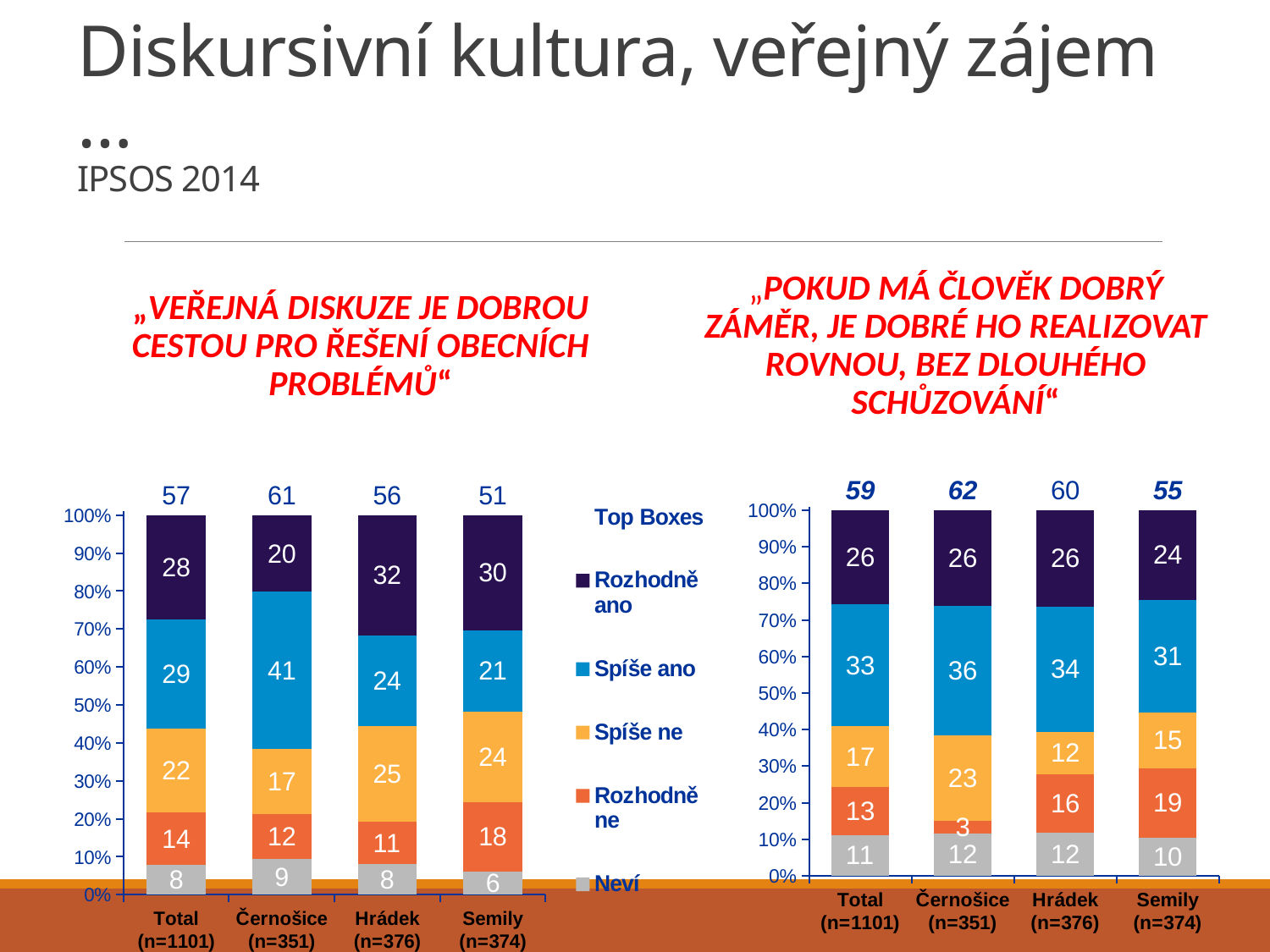
What type of chart is the right chart ("Pokud má člověk dobrý záměr...")? Stacked bar chart In the right chart, which category has the lowest Top Boxes value shown above the bars? Semily (n=374) In the right chart, what is the Top Boxes value shown above the Total (n=1101) bar? 59 In the right chart, which is larger: the "Spíše ne" value for Černošice (n=351) or for Hrádek (n=376)? Černošice (n=351) In the left chart, what is the difference between the "Rozhodně ano" values for Hrádek (n=376) and Černošice (n=351)? 12 Which legend entry is shown in the darkest (navy) colour? Rozhodně ano How many categories are shown on the x axis of the left chart? 4 How many series does the legend between the two charts list? 6 In the left chart ("Veřejná diskuze je dobrou cestou..."), what is the value of "Spíše ano" for Černošice (n=351)? 41 In the left chart, what is the "Neví" value for Semily (n=374)? 6 In the right chart ("Pokud má člověk dobrý záměr..."), what is the value of "Rozhodně ne" for Černošice (n=351)? 3 In the left chart, which category has the highest Top Boxes value shown above the bars? Černošice (n=351)